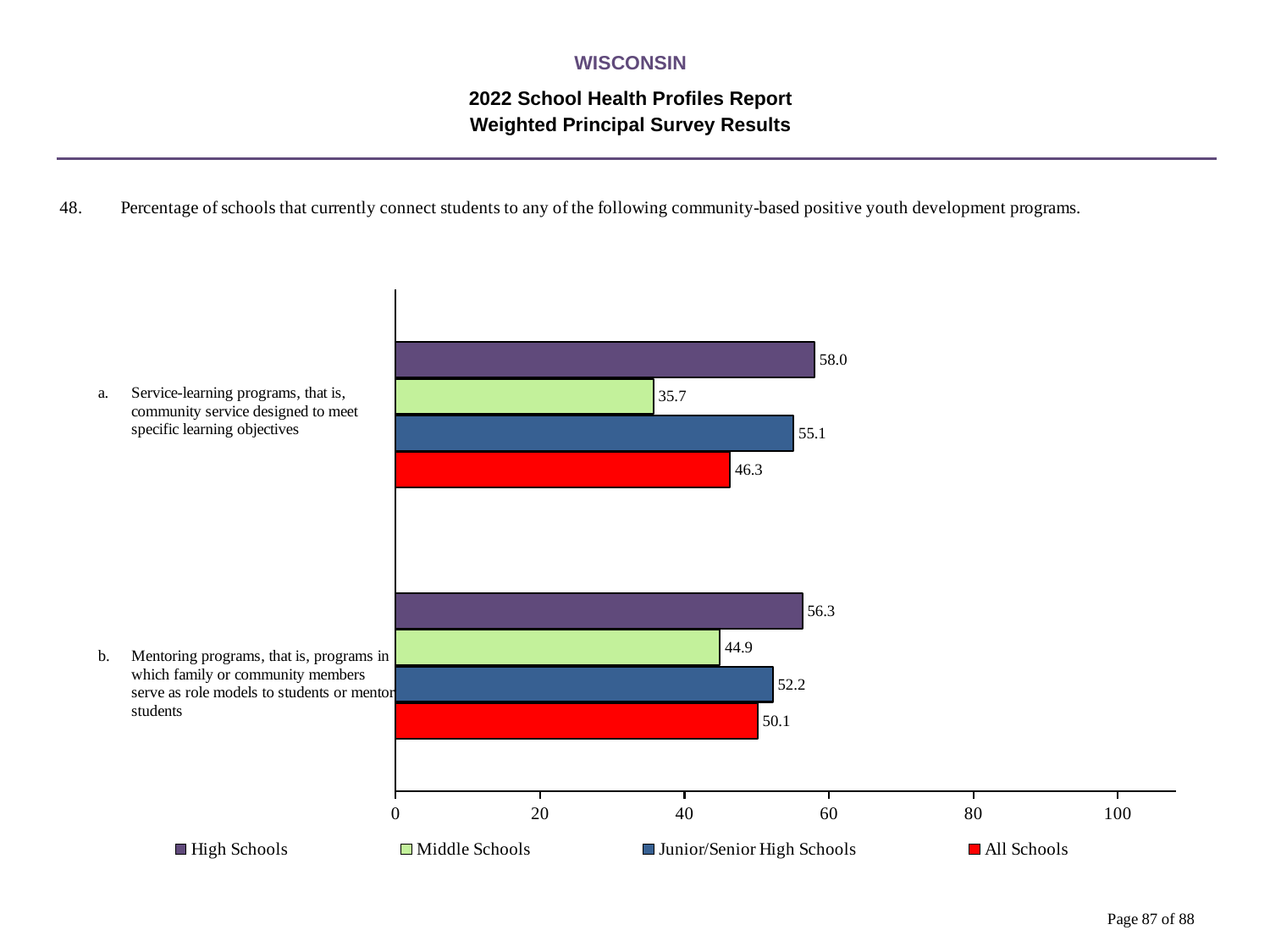
What is the value for Junior/Senior High Schools for mentoring programs (item b)? 52.2 What is the value for High Schools for service-learning programs (item a)? 58.0 Which is larger for mentoring programs (item b): the Junior/Senior High Schools value or the All Schools value? Junior/Senior High Schools Which school type has the lowest value for service-learning programs (item a)? Middle Schools What is the value for Middle Schools for mentoring programs (item b)? 44.9 What is the value for All Schools for service-learning programs (item a)? 46.3 Is the value for Middle Schools for service-learning programs (item a) greater or less than 40? less Which school type has the highest value for mentoring programs (item b)? High Schools What colour represents All Schools in the chart? red What is the difference between the High Schools and Middle Schools values for service-learning programs (item a)? 22.3 What kind of chart is shown on the slide? bar chart How many series does the legend list? 4